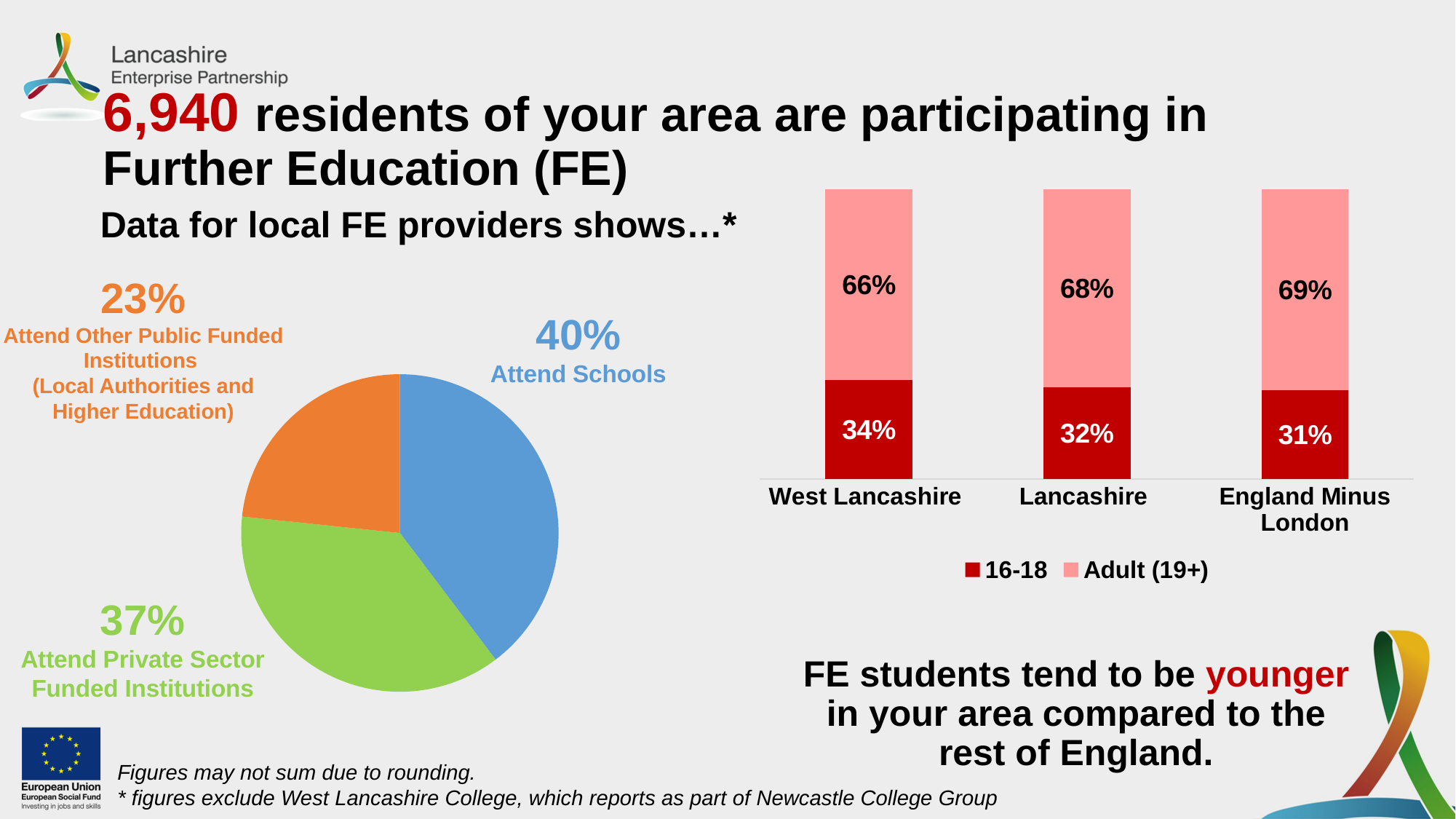
In the stacked bar chart on the right, which area has the highest share of 16-18 students? West Lancashire What type of chart is shown on the right of the slide? Stacked bar chart In the pie chart on the left, how many slices are there? 3 In the pie chart on the left, what share of FE participants attend schools? 40% In the pie chart on the left, which category has the smallest share? Attend Other Public Funded Institutions (Local Authorities and Higher Education) In the stacked bar chart on the right, what percentage of FE students in England Minus London are Adult (19+)? 69% In the pie chart on the left, which category has the largest share? Attend Schools In the pie chart on the left, what is the difference between the share attending schools and the share attending other public funded institutions? 17% In the stacked bar chart on the right, what percentage of FE students in West Lancashire are aged 16-18? 34% In the stacked bar chart on the right, how many series does the legend list? 2 In the stacked bar chart on the right, what is the difference between the Adult (19+) share in Lancashire and in West Lancashire? 2% In the pie chart on the left, what share attend private sector funded institutions? 37%